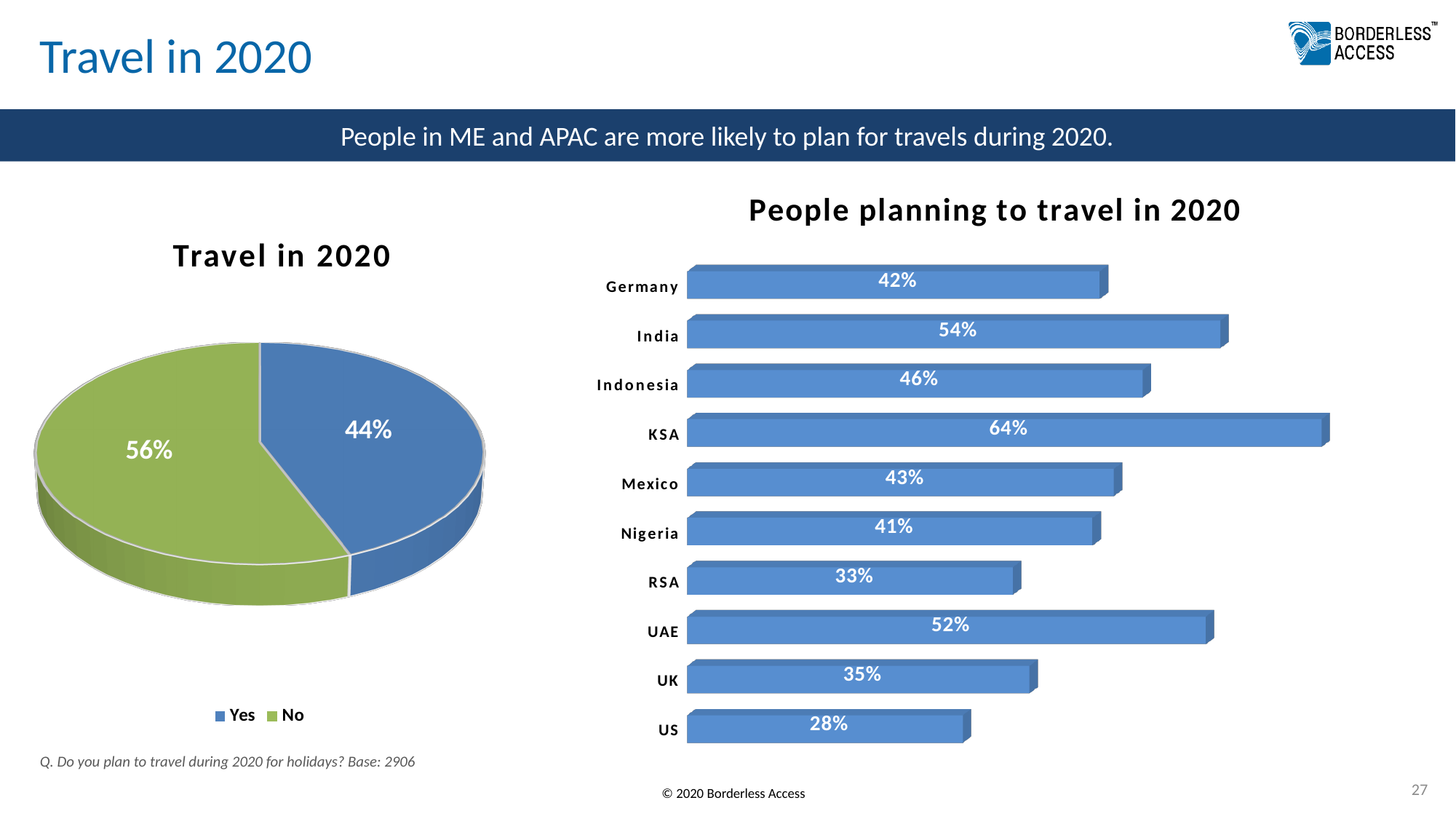
What kind of chart is 'Travel in 2020'? Pie chart In the 'People planning to travel in 2020' chart, what is the difference between the values for India and the UK? 19% In the 'People planning to travel in 2020' chart, what is the value for KSA? 64% In the 'People planning to travel in 2020' chart, which country has the lowest value? US In the 'People planning to travel in 2020' chart, which is larger, the value for UAE or the value for Indonesia? UAE How many entries does the legend of the 'Travel in 2020' pie chart list? 2 In the 'Travel in 2020' pie chart, what share of respondents answered 'No'? 56% How many countries are shown in the 'People planning to travel in 2020' chart? 10 In the 'People planning to travel in 2020' chart, which country has the highest value? KSA In the 'People planning to travel in 2020' chart, what is the value for Nigeria? 41% What kind of chart is 'People planning to travel in 2020'? Bar chart In the 'Travel in 2020' pie chart, what is the value for 'Yes'? 44%